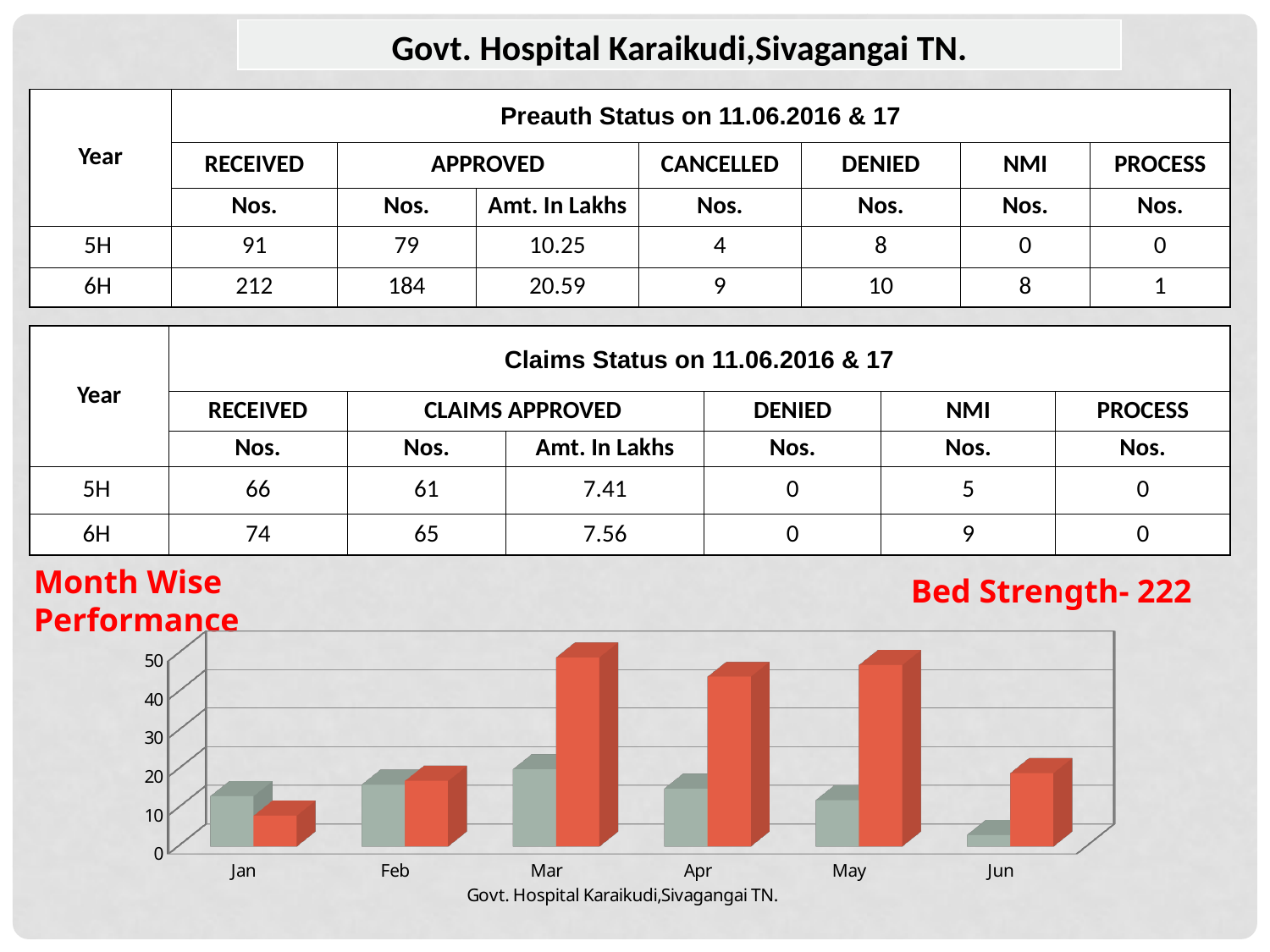
How many bars are plotted for each month in the chart? 2 What kind of chart is shown on the slide? bar chart Is the value of the grey bar for Mar greater or less than 30? less Is the value of the grey bar for Jun greater or less than 10? less Which month has the lowest red bar? Jan For Mar, which bar is taller, the grey bar or the red bar? the red bar What title is printed below the chart? Govt. Hospital Karaikudi,Sivagangai TN. Is the value of the red bar for Mar greater or less than 40? greater How many months are shown on the x axis of the chart? 6 For Jan, which bar is taller, the grey bar or the red bar? the grey bar Which month has the lowest grey bar? Jun